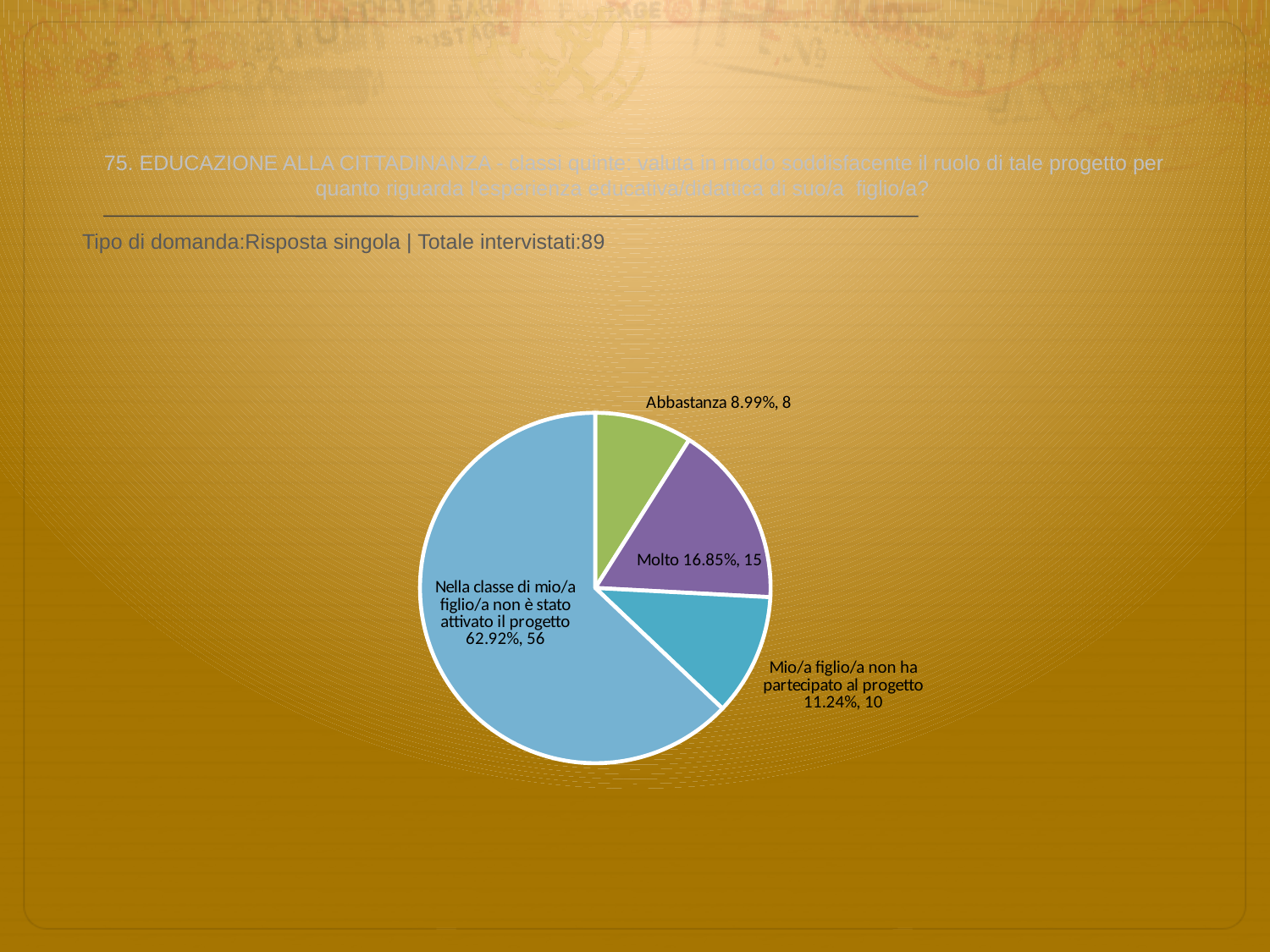
Which slice is the smallest? Abbastanza What percentage is shown for "Nella classe di mio/a figlio/a non è stato attivato il progetto"? 62.92% Which has a larger count, "Molto" or "Mio/a figlio/a non ha partecipato al progetto"? Molto What kind of chart is shown on the slide? Pie chart What percentage is shown for the "Abbastanza" slice? 8.99% How many slices does the pie chart have? 4 What is the difference in count between "Molto" and "Abbastanza"? 7 What is the count for "Mio/a figlio/a non ha partecipato al progetto"? 10 What is the combined count of the "Molto" and "Abbastanza" slices? 23 What is the total number of respondents (Totale intervistati) stated on the slide? 89 Which slice is the largest? Nella classe di mio/a figlio/a non è stato attivato il progetto What is the count for the "Molto" slice? 15